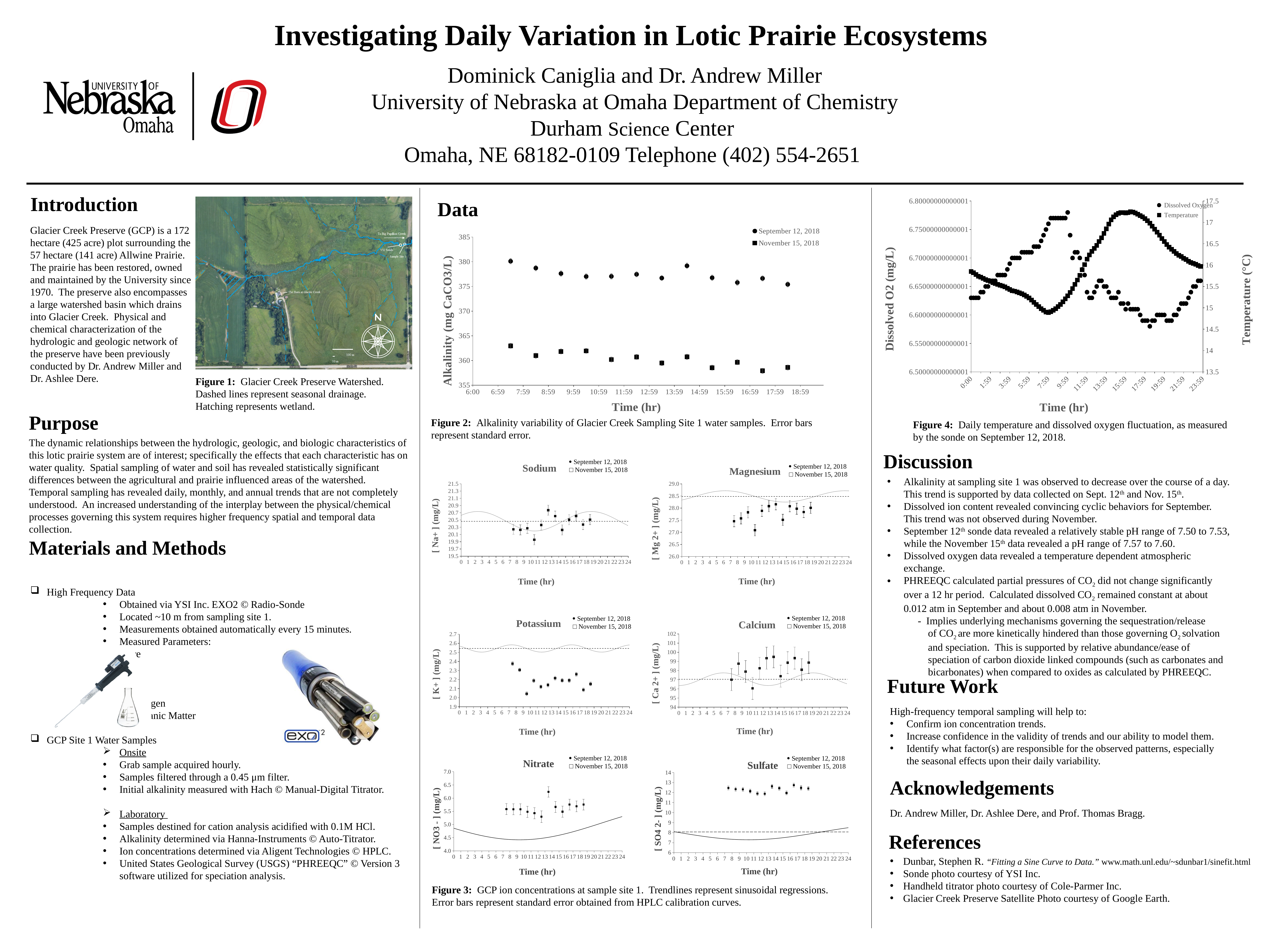
In Figure 4 (Daily temperature and dissolved oxygen), what is the label of the right-hand vertical axis? Temperature (°C) In Figure 2 (Alkalinity), how many series does the legend list? 2 In the Sulfate chart of Figure 3, are the September 12, 2018 values greater or less than 10? greater In Figure 4, is the Temperature value at 17:59 greater or less than 15? greater How many ion concentration charts are shown in Figure 3? 6 In Figure 2 (Alkalinity), which series has the higher values, September 12, 2018 or November 15, 2018? September 12, 2018 What kind of chart is Figure 2 (Alkalinity variability)? scatter chart In Figure 2 (Alkalinity), is the first September 12, 2018 value (around 7:00) greater or less than 375? greater In Figure 4 (Daily temperature and dissolved oxygen), how many series does the legend list? 2 In Figure 2 (Alkalinity), do the September 12, 2018 values generally rise or fall from 7:00 to 18:00? fall